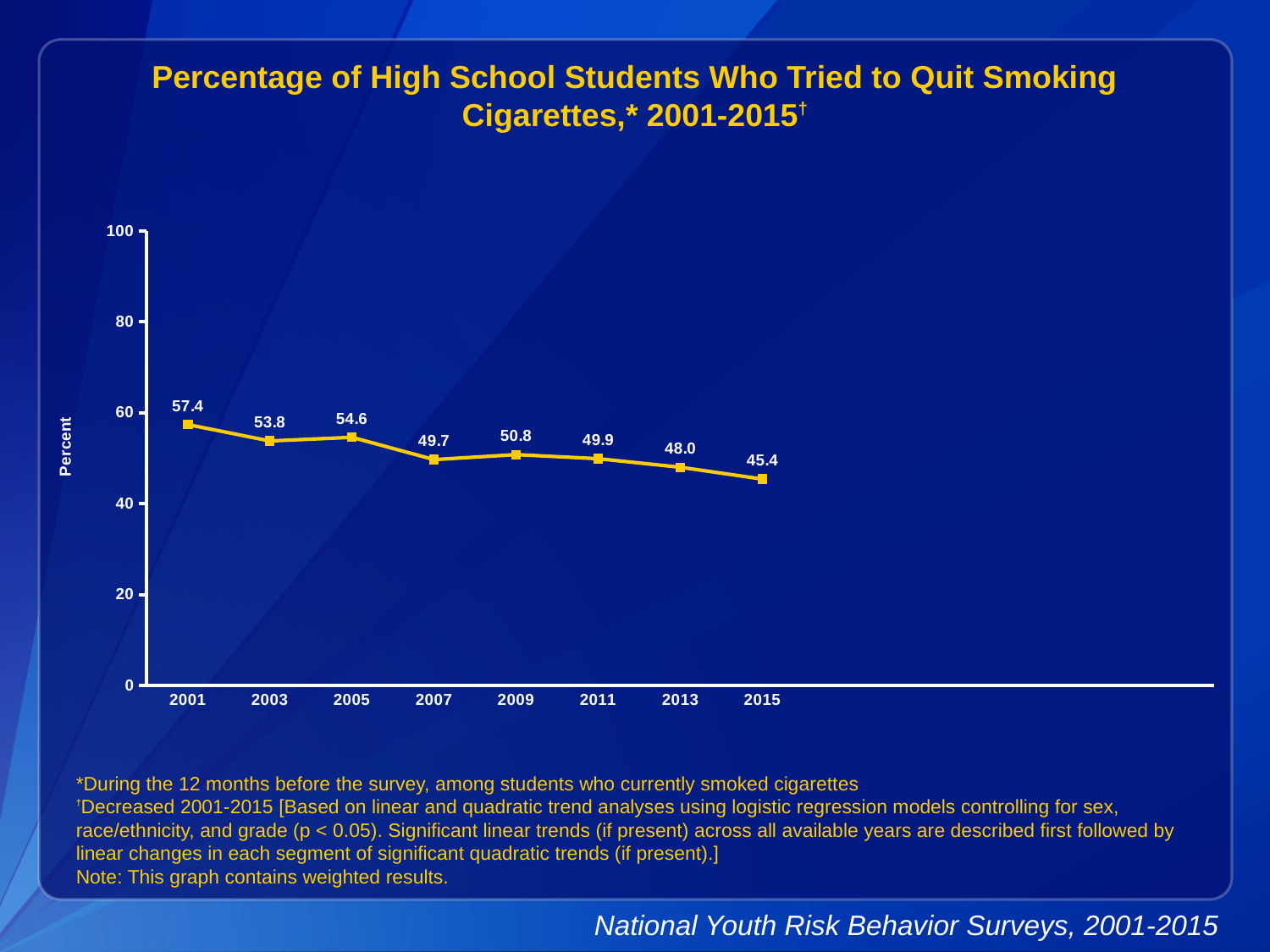
Which year has the lowest percentage of students who tried to quit smoking? 2015 Which year has the highest percentage of students who tried to quit smoking? 2001 Which year has a larger value, 2005 or 2007? 2005 Do the values generally rise or fall from 2001 to 2015? fall How many years are plotted on the chart? 8 What is the difference between the 2001 value and the 2015 value? 12.0 What was the percentage of high school students who tried to quit smoking cigarettes in 2001? 57.4 What is the label on the vertical axis? Percent What was the percentage of high school students who tried to quit smoking cigarettes in 2015? 45.4 What value is plotted for 2009? 50.8 What kind of chart is shown on the slide? line chart Is the value for 2013 greater or less than 60? less